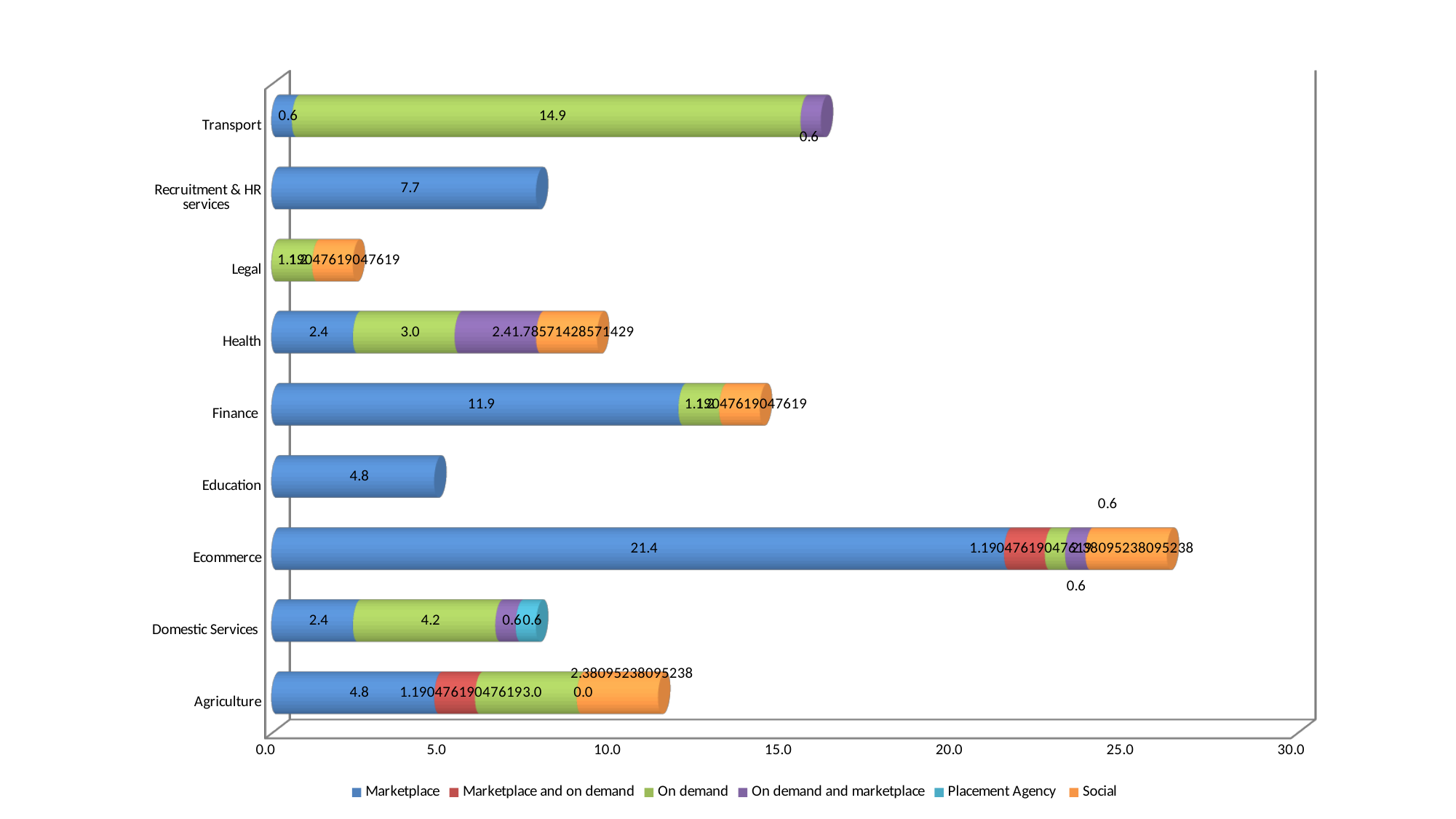
What is the Marketplace value for Ecommerce? 21.4 What is the On demand value for Domestic Services? 4.2 What is the difference between the Marketplace value for Ecommerce and the Marketplace value for Finance? 9.5 How many series does the legend list? 6 What type of chart is shown on the slide? Stacked bar chart What is the On demand value for Transport? 14.9 Which category has the highest Marketplace value? Ecommerce What is the Marketplace value for Recruitment & HR services? 7.7 Is the total length of the Ecommerce bar greater or less than 25.0? greater How many categories are shown on the vertical axis? 9 What is the Marketplace value for Finance? 11.9 Which is larger, the Marketplace value for Education or the Marketplace value for Recruitment & HR services? Recruitment & HR services